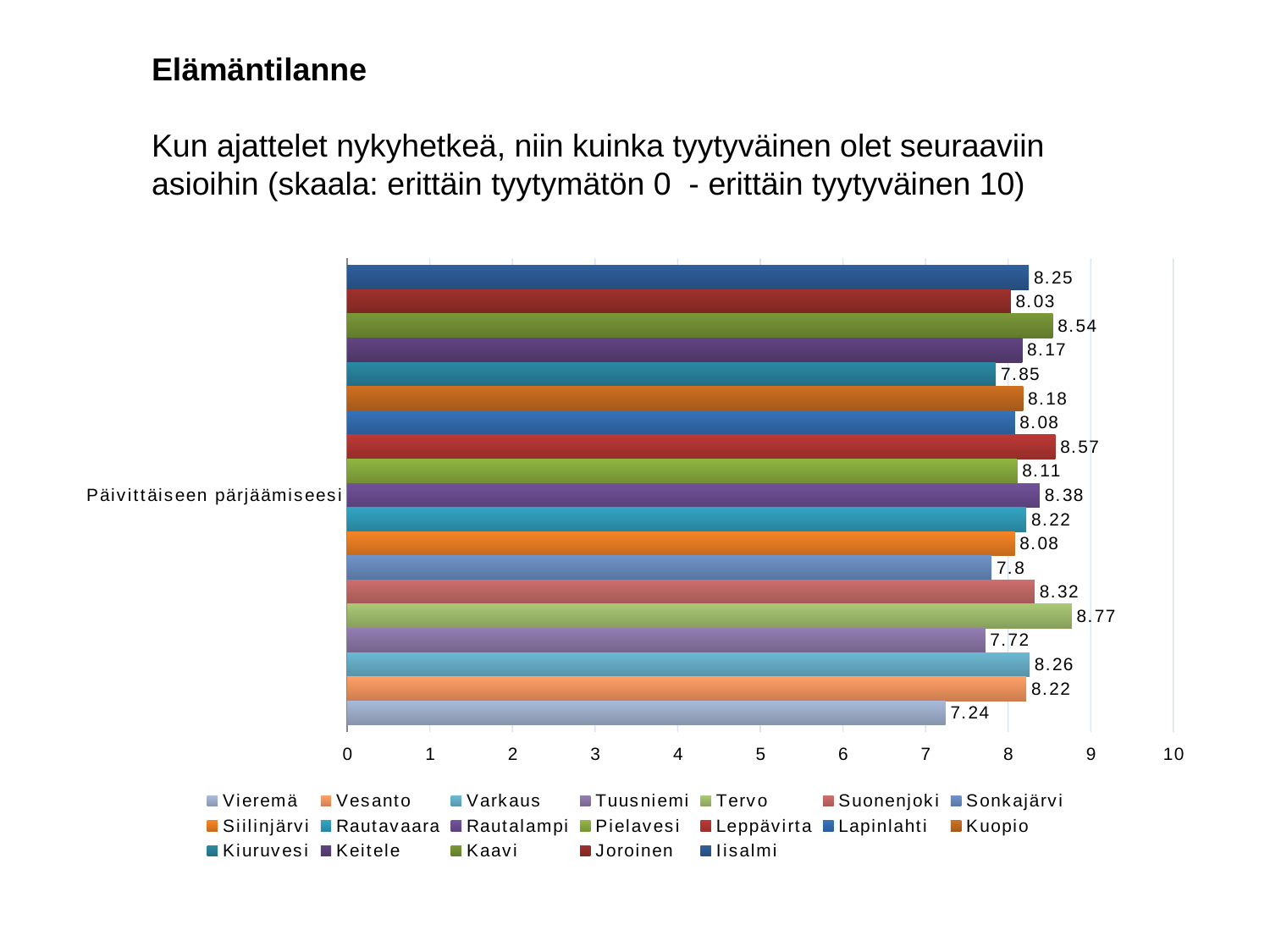
What is the value for Leppävirta? 8.57 Is the value for Tuusniemi greater or less than 8? less What is the value for Tervo? 8.77 What kind of chart is shown on the slide? bar chart What is the value for Vieremä? 7.24 What is the category label shown on the vertical axis of the chart? Päivittäiseen pärjäämiseesi How many series does the legend list? 19 Which municipality has the lowest value? Vieremä Which has a larger value, Kaavi or Joroinen? Kaavi What is the value for Kuopio? 8.18 Which municipality has the highest value? Tervo What is the difference between the values for Tervo and Vieremä? 1.53